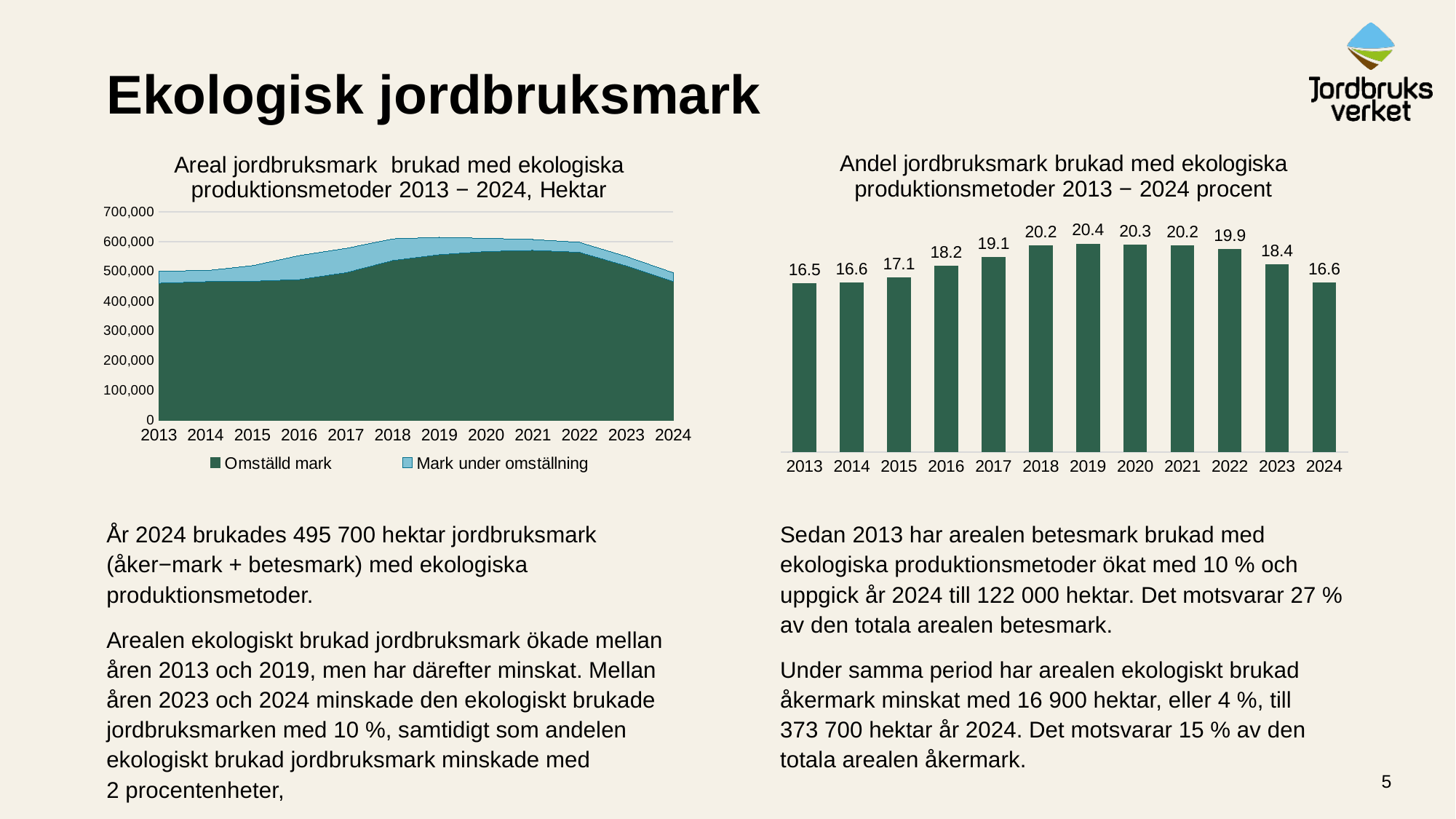
In the chart 'Areal jordbruksmark brukad med ekologiska produktionsmetoder 2013 − 2024, Hektar', is the total value for 2019 greater or less than 600,000? greater In the chart 'Andel jordbruksmark brukad med ekologiska produktionsmetoder 2013 − 2024 procent', which is larger, the value for 2016 or the value for 2023? 2023 In the chart 'Areal jordbruksmark brukad med ekologiska produktionsmetoder 2013 − 2024, Hektar', what are the two legend entries? Omställd mark; Mark under omställning In the chart 'Andel jordbruksmark brukad med ekologiska produktionsmetoder 2013 − 2024 procent', what is the value for 2019? 20.4 In the chart 'Andel jordbruksmark brukad med ekologiska produktionsmetoder 2013 − 2024 procent', which year has the lowest value? 2013 In the chart 'Andel jordbruksmark brukad med ekologiska produktionsmetoder 2013 − 2024 procent', what is the value for 2024? 16.6 How many years are shown in the chart 'Andel jordbruksmark brukad med ekologiska produktionsmetoder 2013 − 2024 procent'? 12 How many series does the legend list in the chart 'Areal jordbruksmark brukad med ekologiska produktionsmetoder 2013 − 2024, Hektar'? 2 In the chart 'Andel jordbruksmark brukad med ekologiska produktionsmetoder 2013 − 2024 procent', what is the difference between the values for 2019 and 2024? 3.8 What kind of chart is 'Andel jordbruksmark brukad med ekologiska produktionsmetoder 2013 − 2024 procent'? bar chart In the chart 'Andel jordbruksmark brukad med ekologiska produktionsmetoder 2013 − 2024 procent', which year has the highest value? 2019 In the chart 'Areal jordbruksmark brukad med ekologiska produktionsmetoder 2013 − 2024, Hektar', is the value for 'Omställd mark' in 2013 greater or less than 500,000? less